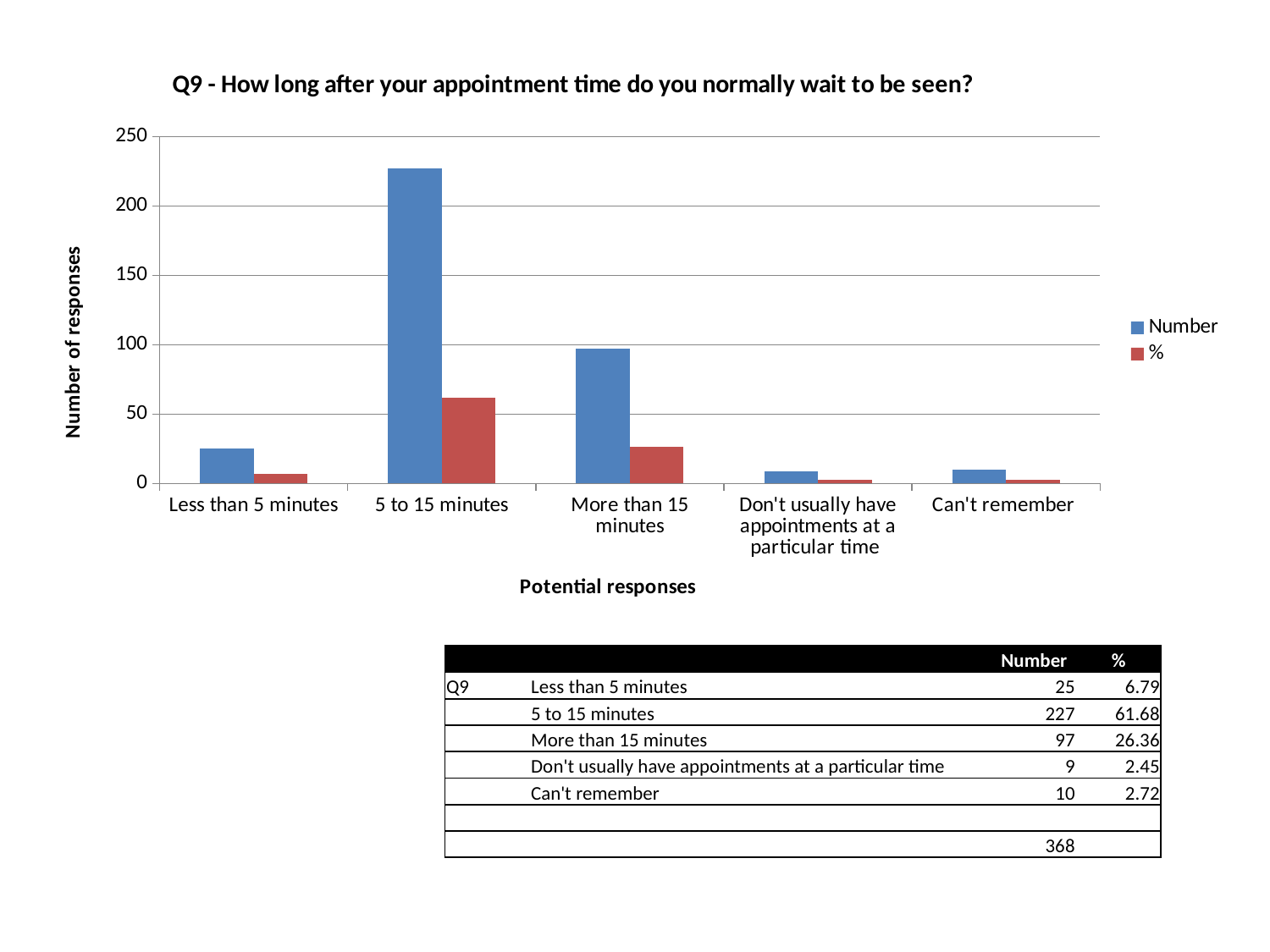
Which response category has the lowest Number of responses? Don't usually have appointments at a particular time Is the Number of responses for '5 to 15 minutes' greater or less than 200? greater How many response categories are shown on the x axis of the chart? 5 What is the Number of responses for 'Can't remember'? 10 Which has a larger Number of responses: 'Less than 5 minutes' or 'Can't remember'? Less than 5 minutes What is the Number of responses for 'More than 15 minutes'? 97 What is the % value for '5 to 15 minutes'? 61.68 What is the label of the y axis of the chart? Number of responses What is the difference in Number of responses between '5 to 15 minutes' and 'More than 15 minutes'? 130 Which response category has the highest Number of responses? 5 to 15 minutes What type of chart is shown on the slide? bar chart How many series does the chart legend list? 2